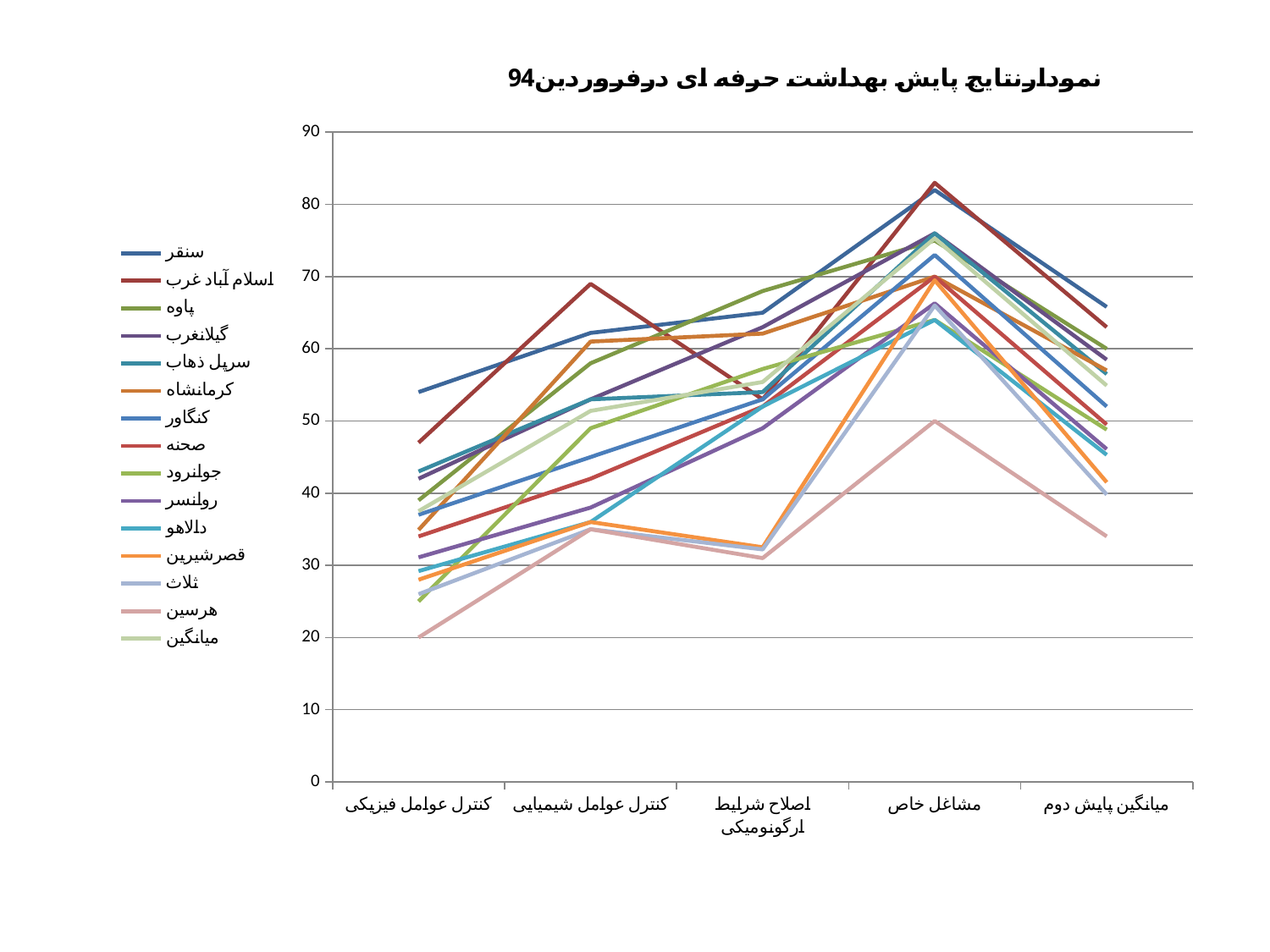
Which series has the lowest value for مشاغل خاص? هرسین Is the value for هرسین at میانگین پایش دوم greater or less than 40? less Which series has the highest value for کنترل عوامل فیزیکی? سنقر How many categories are shown along the x axis? 5 Which series has the highest value for کنترل عوامل شیمیایی? اسلام آباد غرب Which series has the lowest value for کنترل عوامل فیزیکی? هرسین Does the value for هرسین rise or fall from مشاغل خاص to میانگین پایش دوم? fall What kind of chart is shown on the slide? line chart What is the title of the chart? نمودارنتایج پایش بهداشت حرفه ای درفروردین94 Is the value for اسلام آباد غرب at مشاغل خاص greater or less than 80? greater How many series does the legend list? 15 Which is larger at کنترل عوامل فیزیکی, the value for سنقر or the value for هرسین? سنقر